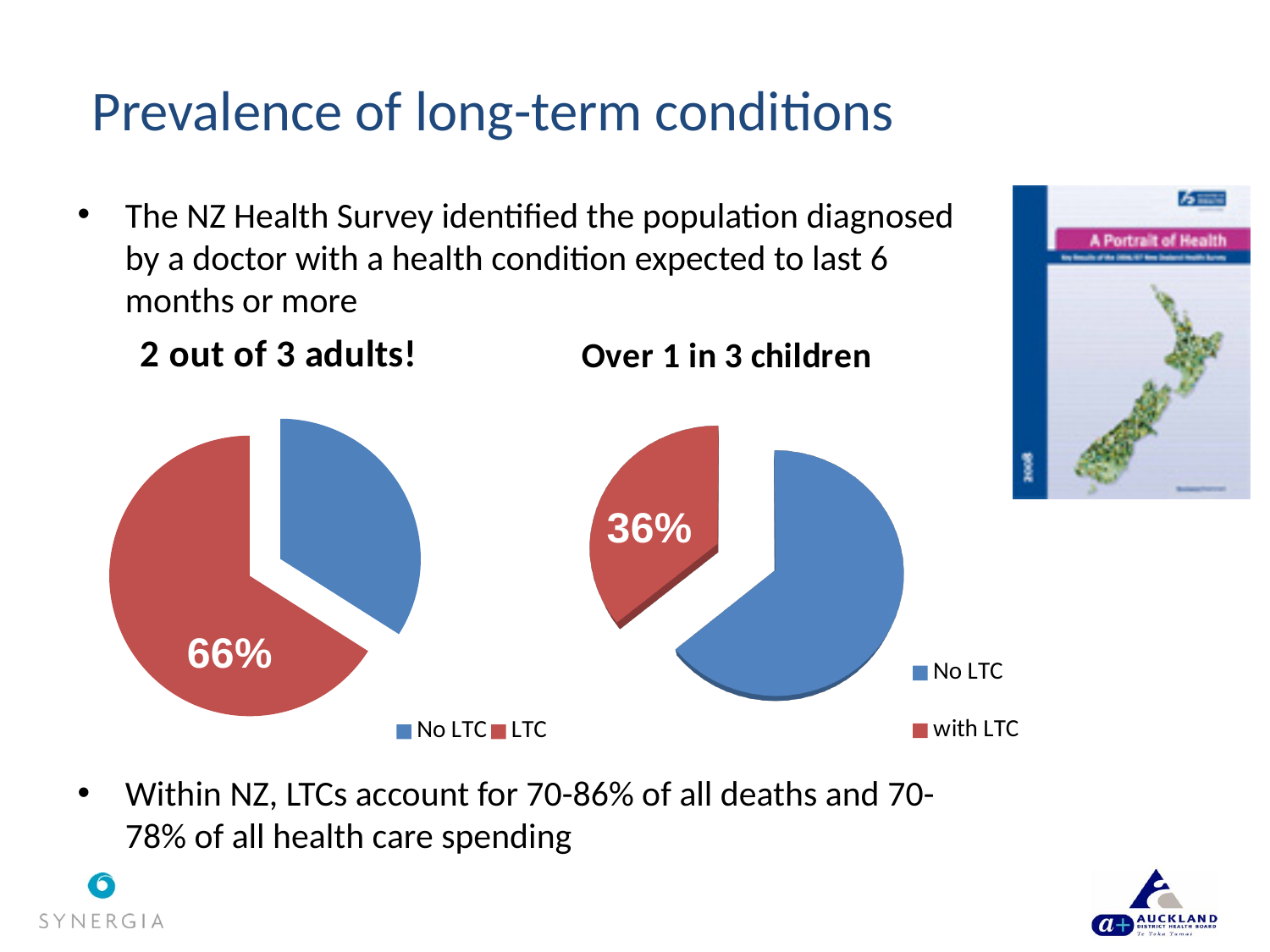
How many entries does the legend of the right pie chart (Over 1 in 3 children) list? 2 What share of the left pie chart (2 out of 3 adults!) does the LTC slice represent? 66% What kind of chart is used for the adults data on the left? Pie chart Is the LTC share for adults in the left pie chart larger or smaller than the 'with LTC' share for children in the right pie chart? Larger What are the two legend entries of the right pie chart (Over 1 in 3 children)? No LTC and with LTC In the left pie chart (2 out of 3 adults!), what colour is the LTC slice? Red In the left pie chart (2 out of 3 adults!), which slice is larger, No LTC or LTC? LTC In the right pie chart (Over 1 in 3 children), what percentage is shown for the 'with LTC' slice? 36% How many slices does the left pie chart (2 out of 3 adults!) have? 2 In the left pie chart (2 out of 3 adults!), what percentage is shown for the LTC slice? 66% In the right pie chart (Over 1 in 3 children), which slice is larger, No LTC or with LTC? No LTC What kind of chart is used for the children data on the right? Pie chart